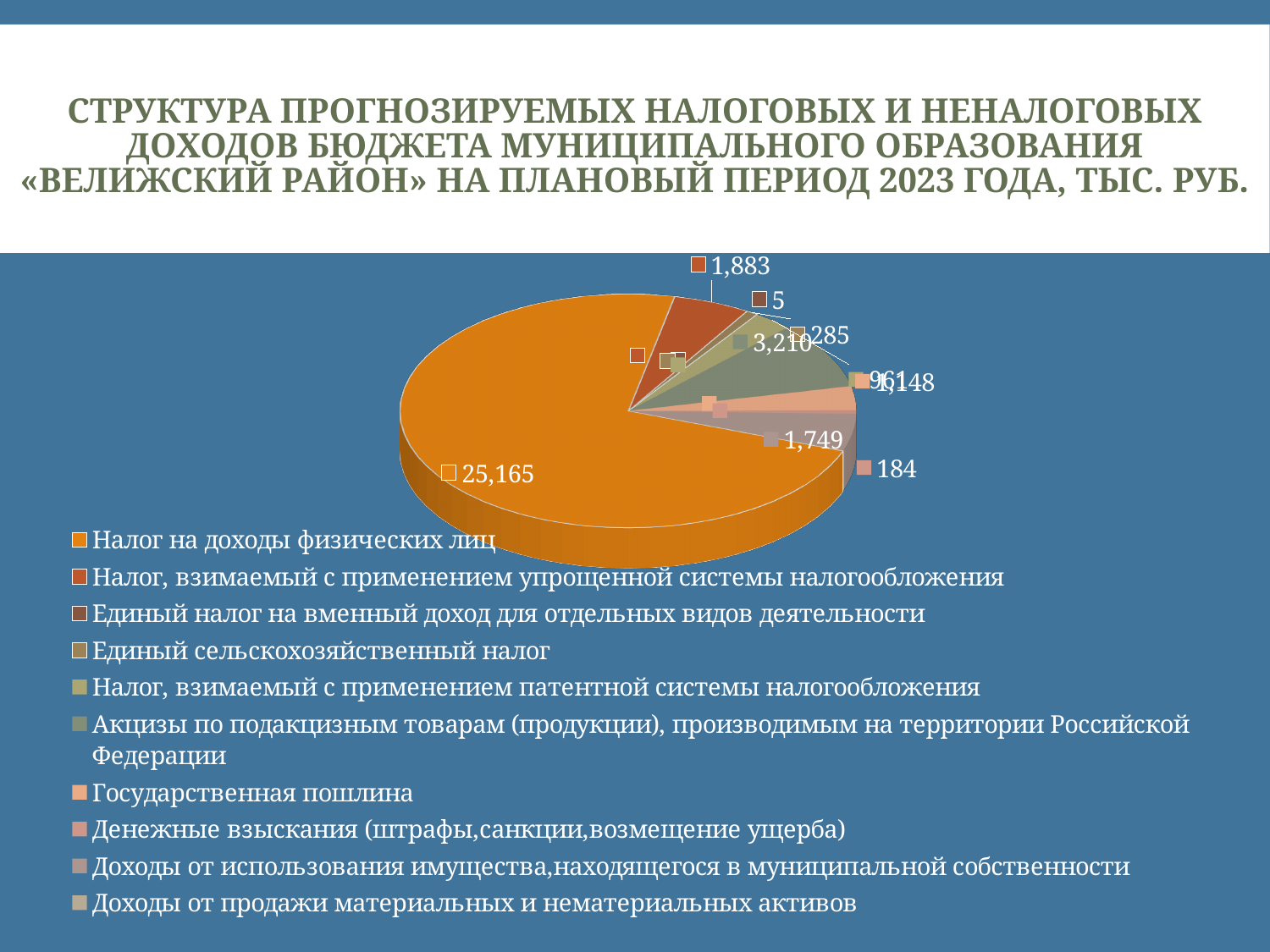
What is the difference between the value for Налог на доходы физических лиц and the value for Налог, взимаемый с применением упрощенной системы налогообложения? 23,282 In what units are the values on the chart given, according to the title? тыс. руб. Which category has the largest slice of the pie? Налог на доходы физических лиц Does the slice for Налог на доходы физических лиц cover more or less than half of the pie? more What colour is the largest slice of the pie? orange What kind of chart is shown on the slide? pie chart What is the value shown for Налог, взимаемый с применением упрощенной системы налогообложения? 1,883 Which is larger: the value for Налог на доходы физических лиц or the value for Налог, взимаемый с применением упрощенной системы налогообложения? Налог на доходы физических лиц What is the smallest value labelled on the pie chart? 5 What is the value shown for Налог на доходы физических лиц? 25,165 How many categories does the legend list? 10